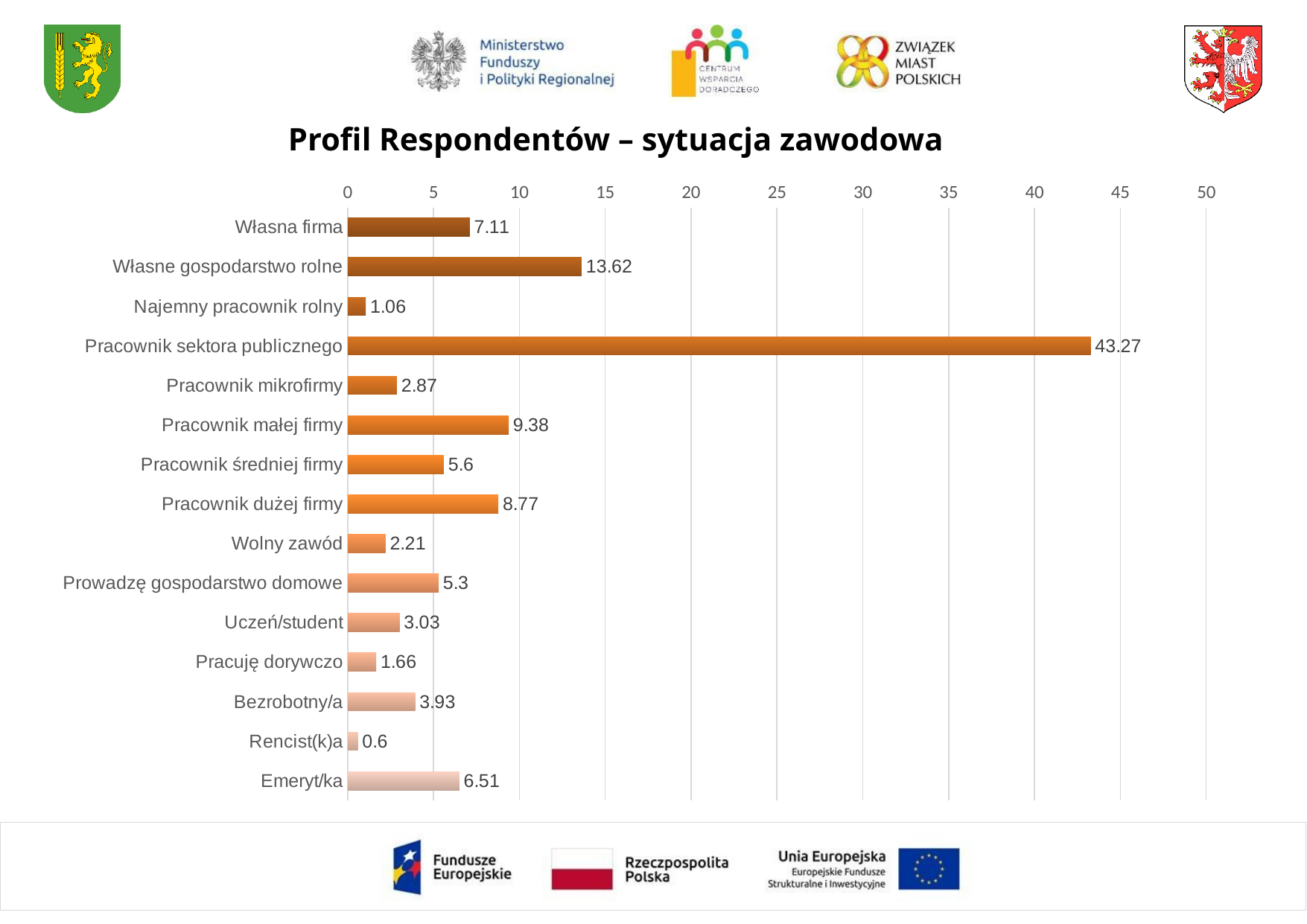
Which category has the lowest value? Rencist(k)a What is the value for Własne gospodarstwo rolne? 13.62 Is the value for Pracownik sektora publicznego greater or less than 40? greater What is the title of the chart? Profil Respondentów – sytuacja zawodowa What kind of chart is shown on the slide? bar chart What is the highest value shown on the horizontal axis? 50 What is the value for Emeryt/ka? 6.51 What is the difference between the values for Pracownik małej firmy and Pracownik dużej firmy? 0.61 What is the value for Pracownik sektora publicznego? 43.27 How many categories are shown in the chart? 15 Which category has the highest value? Pracownik sektora publicznego Which is larger, the value for Własna firma or the value for Emeryt/ka? Własna firma